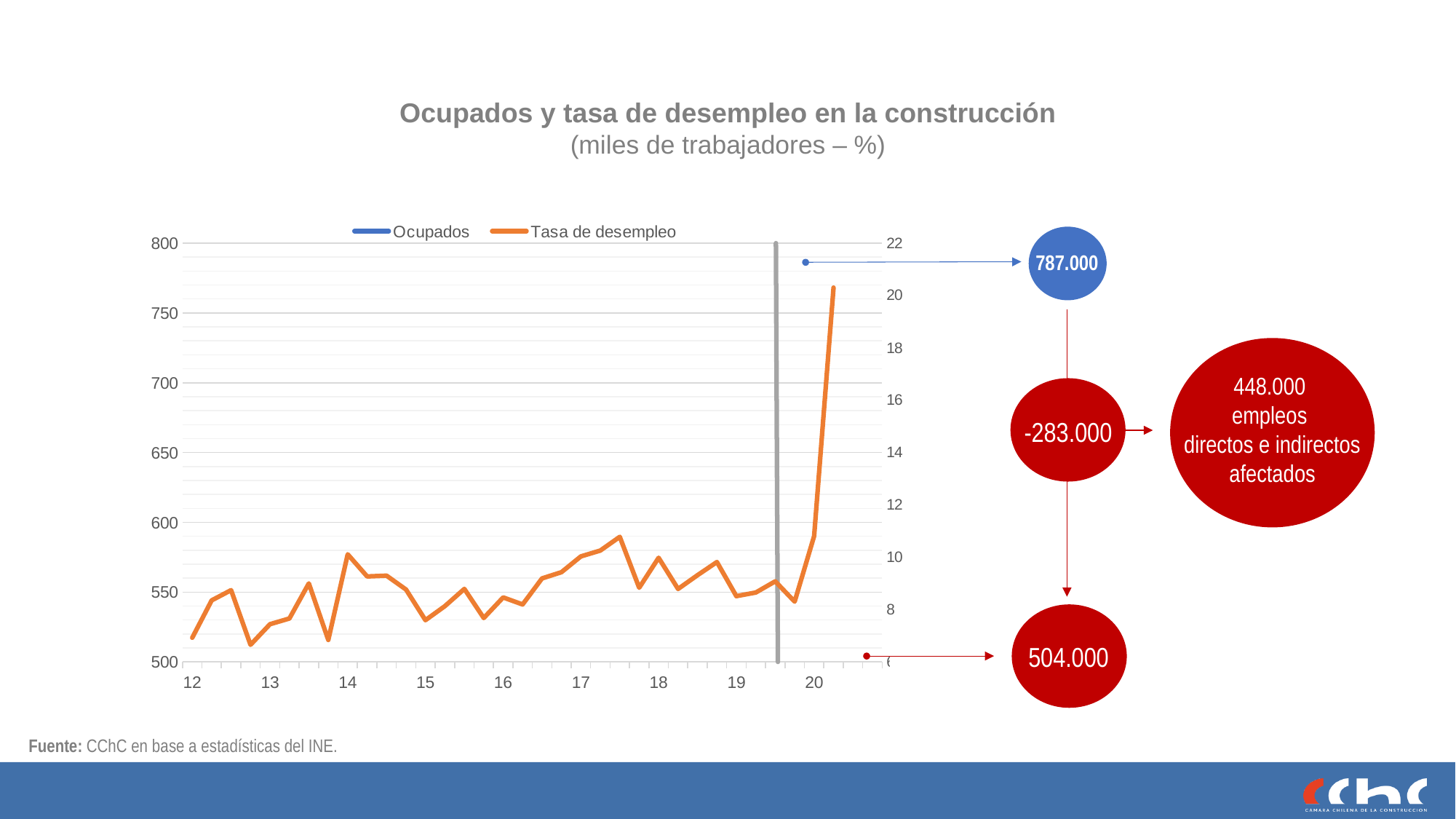
Is the first value of the Tasa de desempleo line (at 12) greater or less than 10 on the right axis? less What kind of chart is shown on the slide? line chart At which x-axis year does the Tasa de desempleo line reach its highest value? 20 Does the Tasa de desempleo line rise or fall at the end of the series, after the vertical grey line? rises What change between 787.000 and 504.000 is shown in the middle red circle? -283.000 Is the Tasa de desempleo value at 17.5 greater or less than 10 on the right axis? greater What are the two series named in the chart legend? Ocupados and Tasa de desempleo What value does the red circle at the bottom, linked to the red point on the chart, show? 504.000 What value does the blue circle linked to the Ocupados point show? 787.000 How many series does the chart legend list? 2 What is the title of the chart? Ocupados y tasa de desempleo en la construcción Is the final value of the Tasa de desempleo line (at 20) greater or less than 18 on the right axis? greater